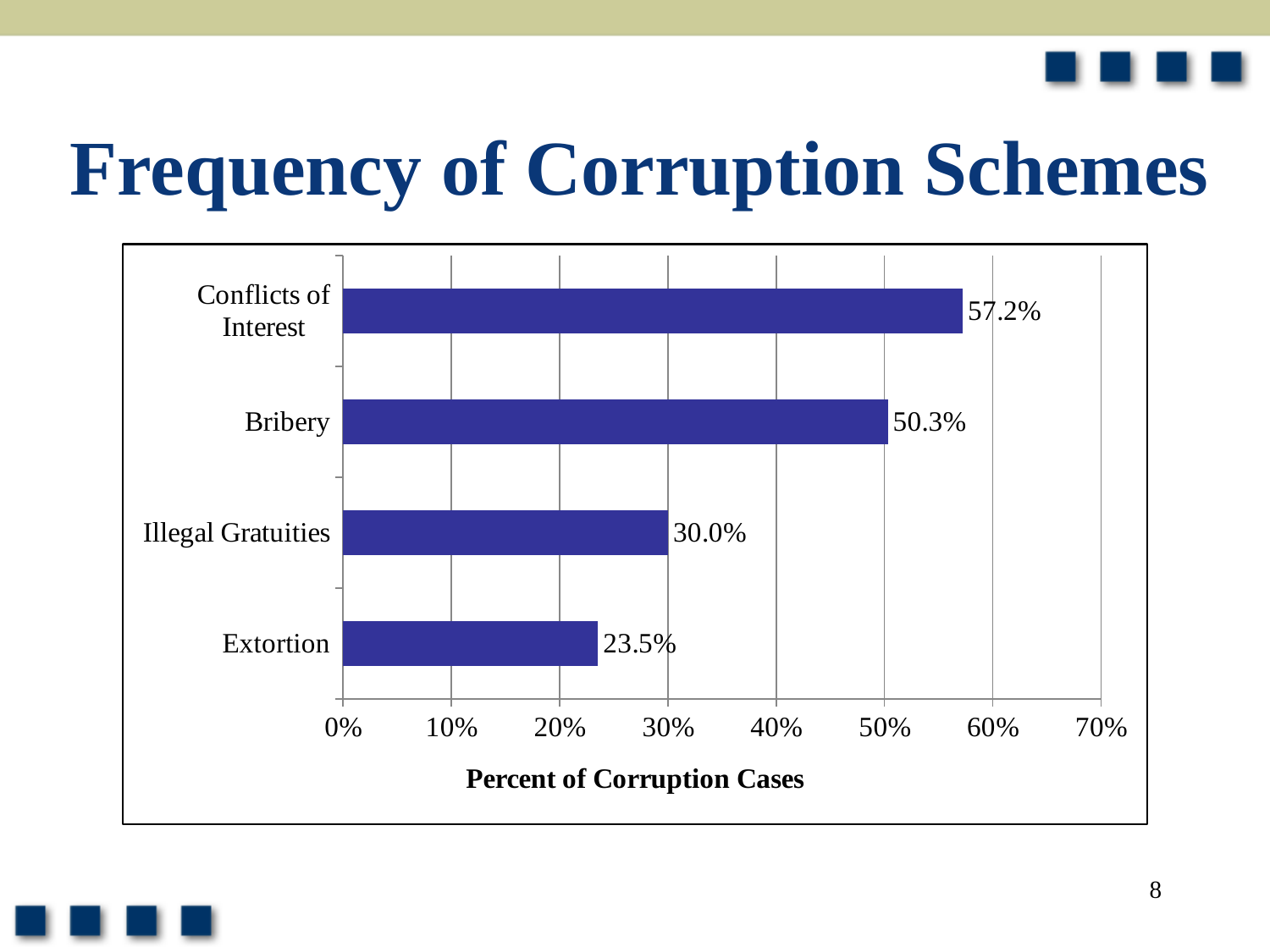
What is the value for Conflicts of Interest? 57.2% Which corruption scheme has the lowest percent of corruption cases? Extortion What is the difference between the values for Conflicts of Interest and Bribery? 6.9% What is the value for Illegal Gratuities? 30.0% Which is larger, the value for Bribery or the value for Illegal Gratuities? Bribery How many corruption schemes are shown in the chart? 4 What is the difference between the values for Illegal Gratuities and Extortion? 6.5% Which corruption scheme has the highest percent of corruption cases? Conflicts of Interest What kind of chart is shown on the slide? Bar chart What is the value for Bribery? 50.3% What is the label of the horizontal axis? Percent of Corruption Cases What is the value for Extortion? 23.5%